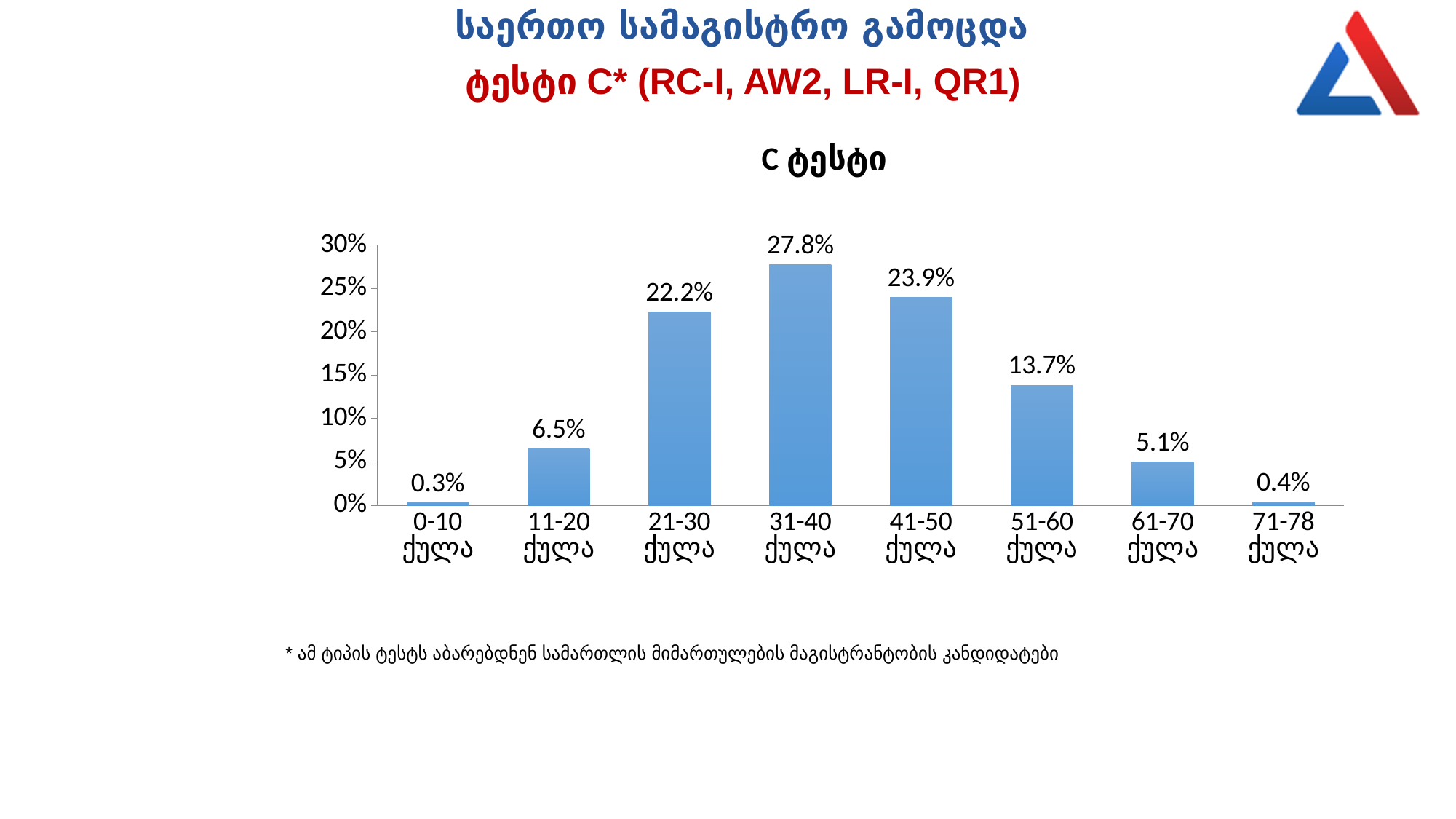
What is the title of the chart? C ტესტი What is the value for the 11-20 ქულა category? 6.5% Is the value for 51-60 ქულა greater or less than 15%? less What kind of chart is shown on the slide? bar chart How many score range categories are shown on the x axis? 8 Which score range has the lowest value? 0-10 ქულა Which score range has the highest value? 31-40 ქულა What is the value for the 31-40 ქულა category? 27.8% What is the difference between the values for 21-30 ქულა and 51-60 ქულა? 8.5% What is the difference between the values for 31-40 ქულა and 41-50 ქულა? 3.9% Which is larger, the value for 21-30 ქულა or the value for 41-50 ქულა? 41-50 ქულა What is the value for the 61-70 ქულა category? 5.1%